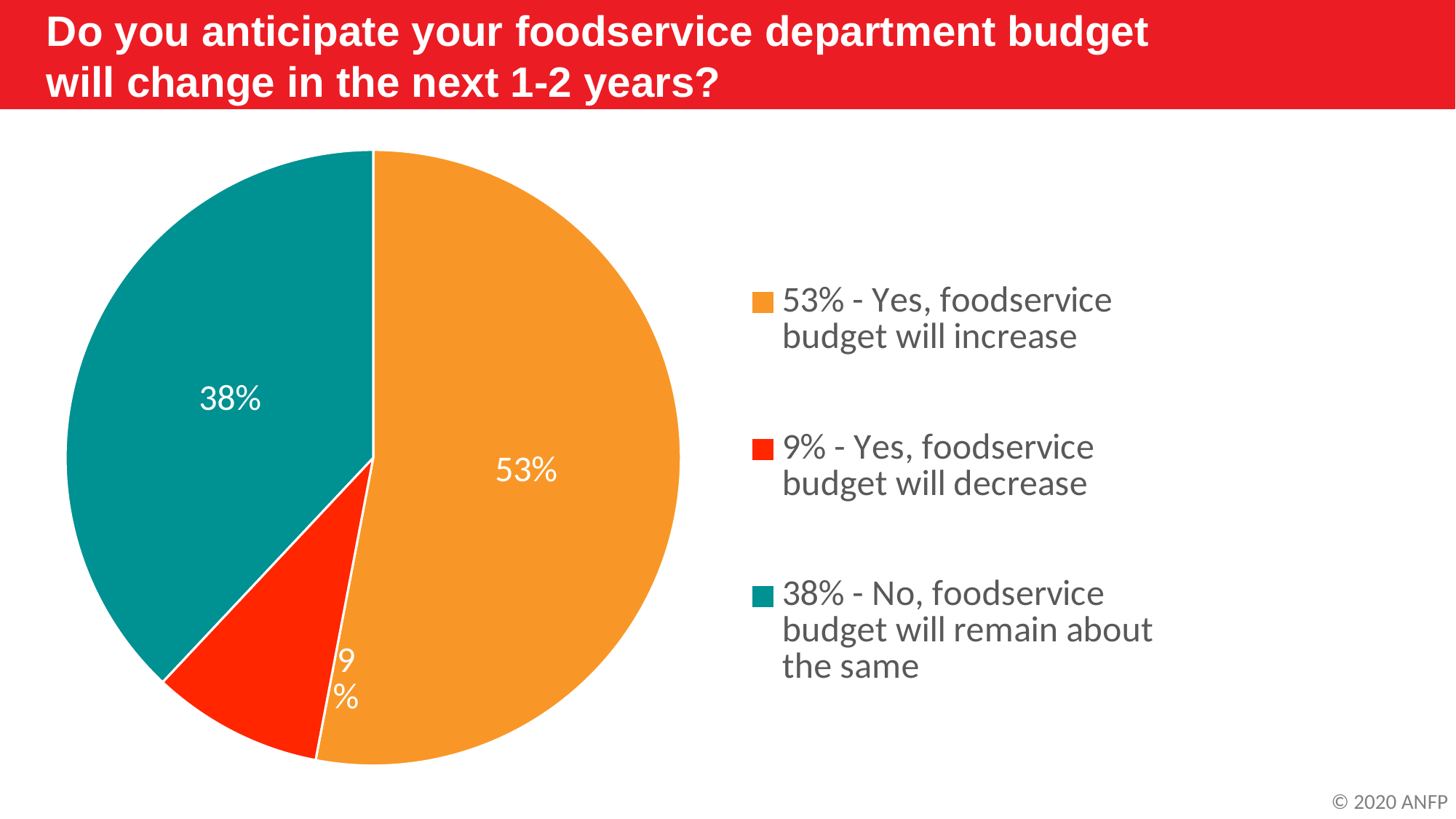
Which response has the largest slice of the pie? Yes, foodservice budget will increase What is the title of the slide containing the chart? Do you anticipate your foodservice department budget will change in the next 1-2 years? What is the difference in percentage points between the 'budget will remain about the same' and 'budget will decrease' slices? 29 What is the difference in percentage points between the 'budget will increase' and 'budget will remain about the same' slices? 15 What share of respondents said their foodservice budget will remain about the same? 38% What share of respondents said their foodservice budget will increase? 53% Which response has the smallest slice of the pie? Yes, foodservice budget will decrease What kind of chart is shown on the slide? pie chart Which is larger: the share saying the budget will remain about the same or the share saying it will decrease? remain about the same What share of respondents said their foodservice budget will decrease? 9% How many slices does the pie chart have? 3 What colour is the slice for 'Yes, foodservice budget will decrease'? red